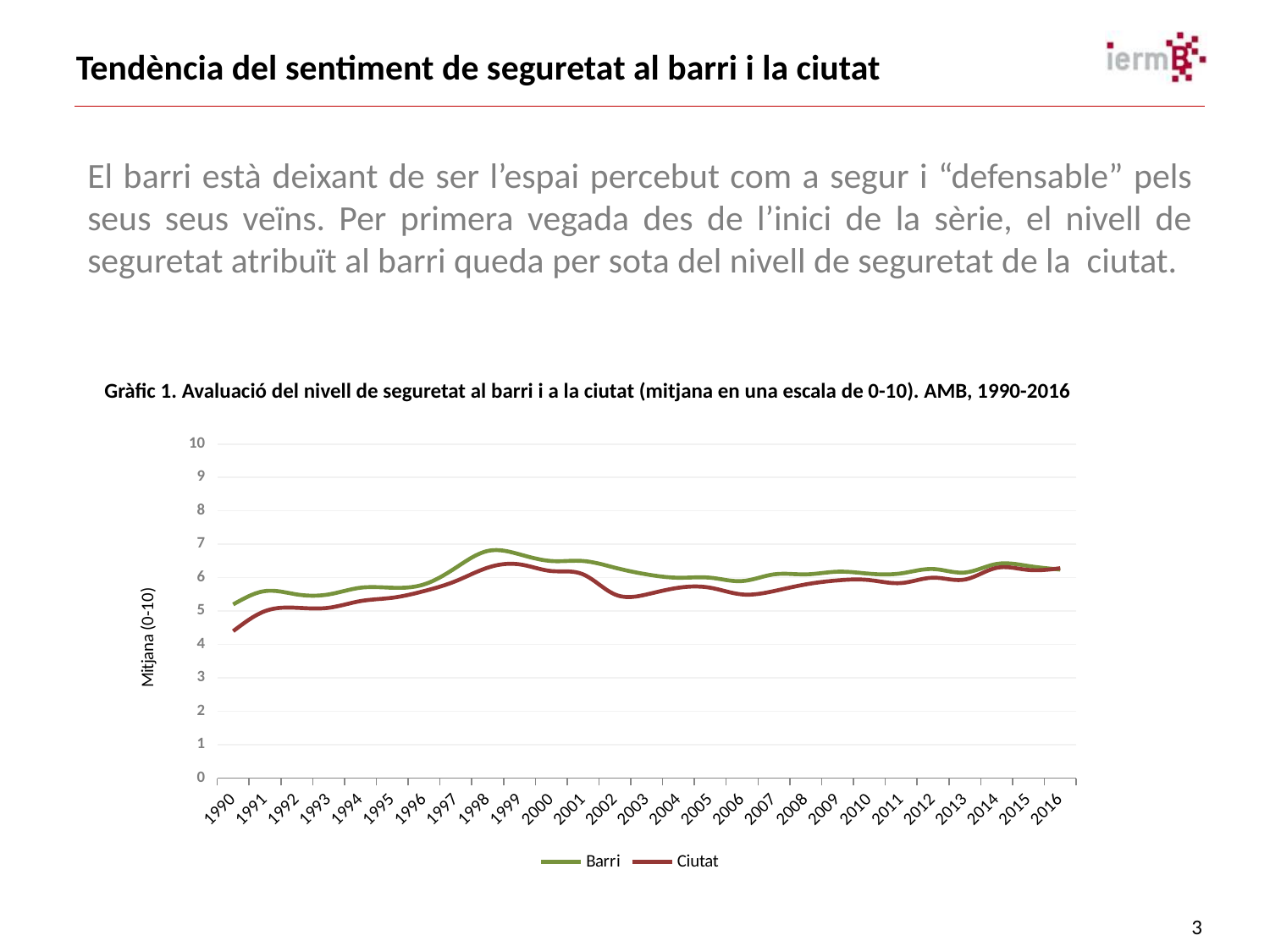
In 1990, which series has the higher value, Barri or Ciutat? Barri How many years are plotted along the x axis? 27 Is the value for Ciutat in 1990 greater or less than 5? less In which year does the Ciutat series have its lowest value? 1990 How many series does the legend list? 2 What kind of chart is shown on the slide? line chart Which series is shown in green? Barri What is the label of the vertical axis? Mitjana (0-10) Is the value for Barri in 1998 greater or less than 6? greater In which year does the Barri series reach its highest value? 1998 Is the value for Ciutat in 2006 greater or less than 6? less